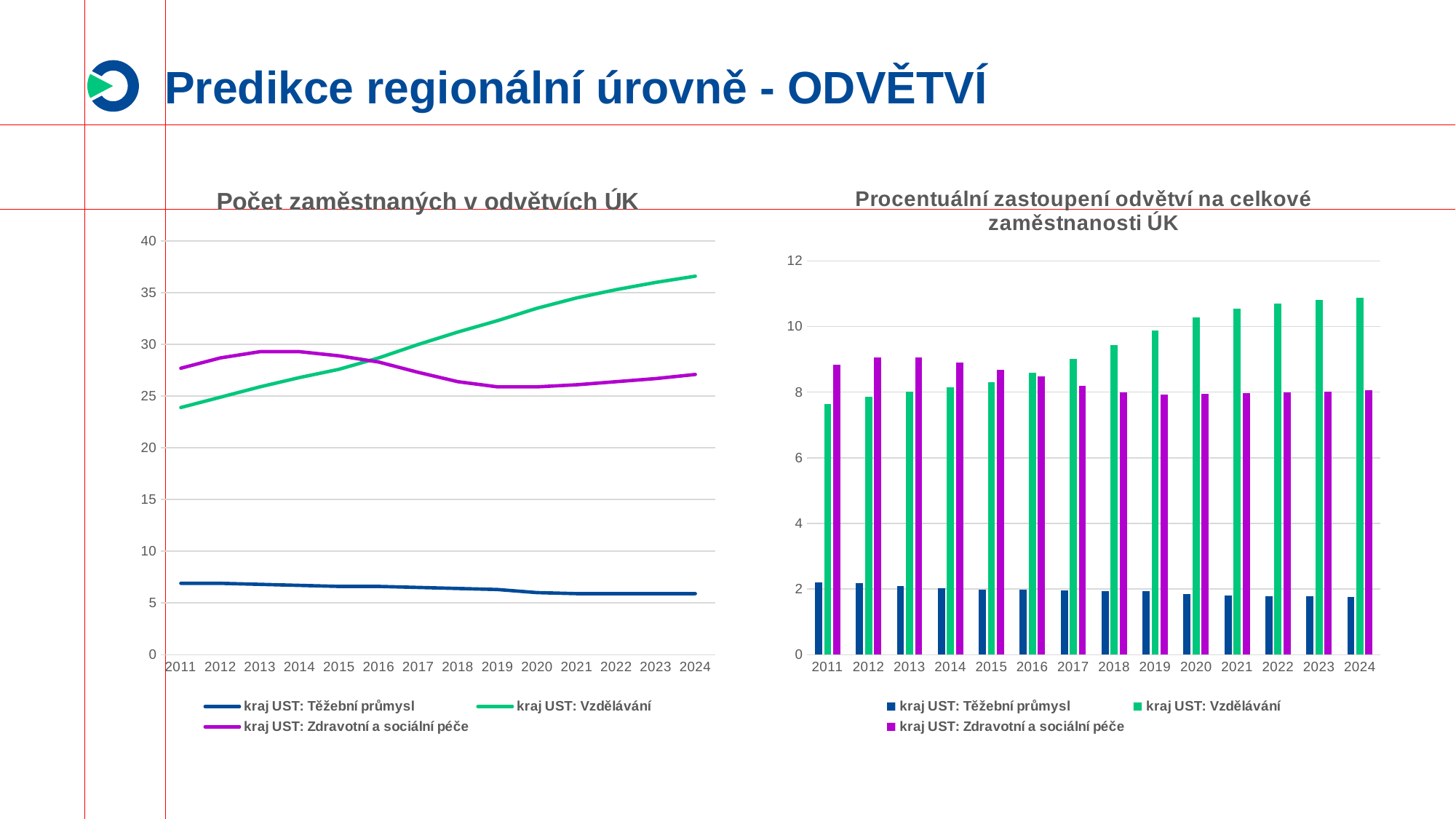
In the left chart "Počet zaměstnaných v odvětvích ÚK", how many series does the legend list? 3 What type of chart is the right chart titled "Procentuální zastoupení odvětví na celkové zaměstnanosti ÚK"? bar chart In the left chart "Počet zaměstnaných v odvětvích ÚK", does the line for kraj UST: Vzdělávání rise or fall from 2011 to 2024? rise In the right chart "Procentuální zastoupení odvětví na celkové zaměstnanosti ÚK", in which year is the bar for kraj UST: Vzdělávání highest? 2024 In the left chart "Počet zaměstnaných v odvětvích ÚK", which series has the highest value in 2024? kraj UST: Vzdělávání In the left chart "Počet zaměstnaných v odvětvích ÚK", is the value for kraj UST: Vzdělávání in 2024 greater or less than 35? greater In the right chart "Procentuální zastoupení odvětví na celkové zaměstnanosti ÚK", how many years are shown on the x axis? 14 What type of chart is the left chart titled "Počet zaměstnaných v odvětvích ÚK"? line chart In the right chart "Procentuální zastoupení odvětví na celkové zaměstnanosti ÚK", is the value for kraj UST: Vzdělávání in 2024 greater or less than 10? greater In the right chart "Procentuální zastoupení odvětví na celkové zaměstnanosti ÚK", which series has the lowest bars in every year? kraj UST: Těžební průmysl In the left chart "Počet zaměstnaných v odvětvích ÚK", is the value for kraj UST: Těžební průmysl in 2011 greater or less than 10? less In the left chart "Počet zaměstnaných v odvětvích ÚK", which series is larger in 2011: kraj UST: Vzdělávání or kraj UST: Zdravotní a sociální péče? kraj UST: Zdravotní a sociální péče